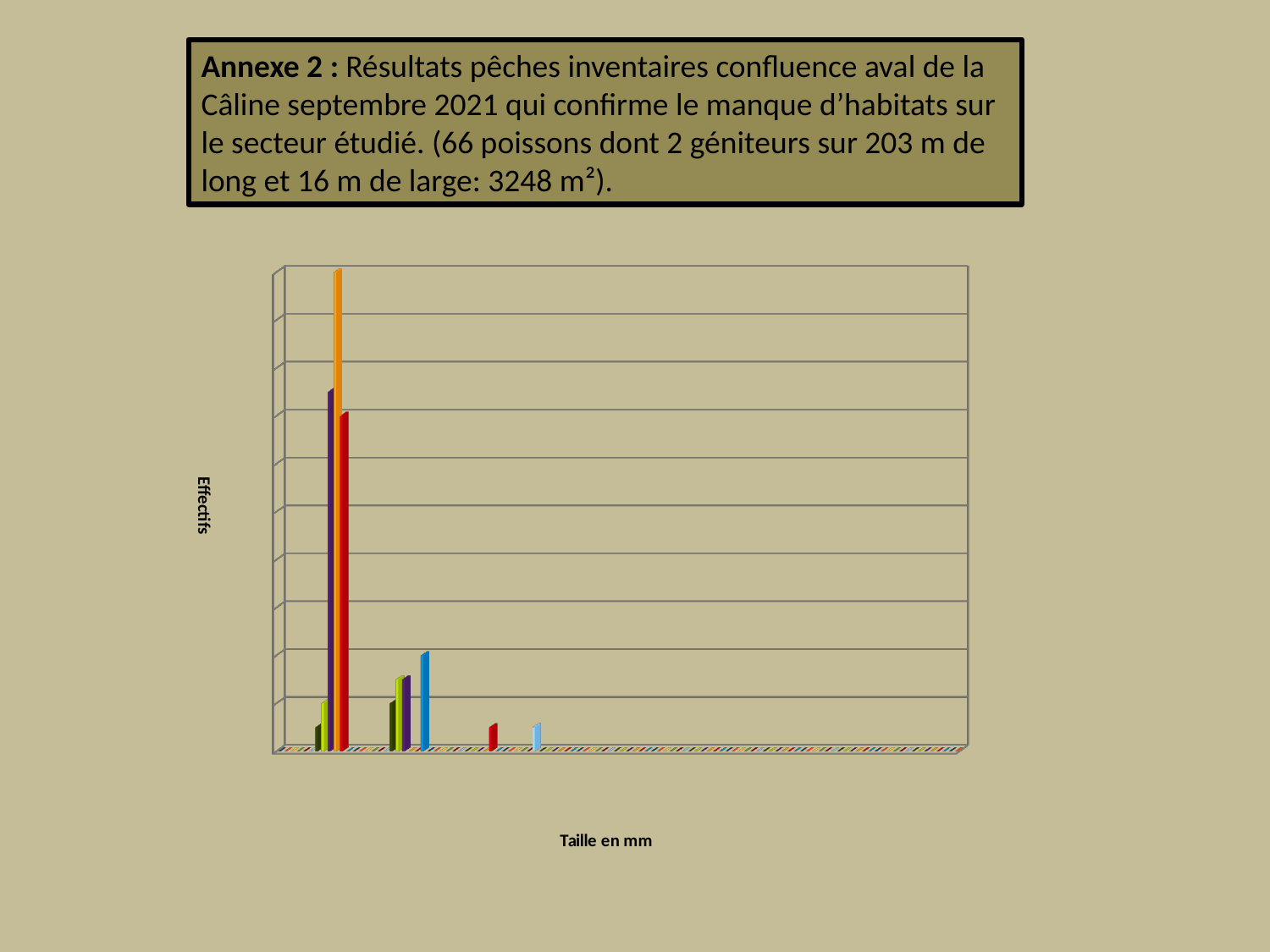
Which coloured bar is the tallest in the chart? orange What kind of chart is shown on the slide? bar chart What is the title of the vertical axis of the chart? Effectifs Do the bar heights generally rise or fall moving from left to right along the x axis? fall In the leftmost group of bars, is the purple bar or the red bar taller? purple In the leftmost group of bars, is the orange bar or the purple bar taller? orange What is the title of the horizontal axis of the chart? Taille en mm